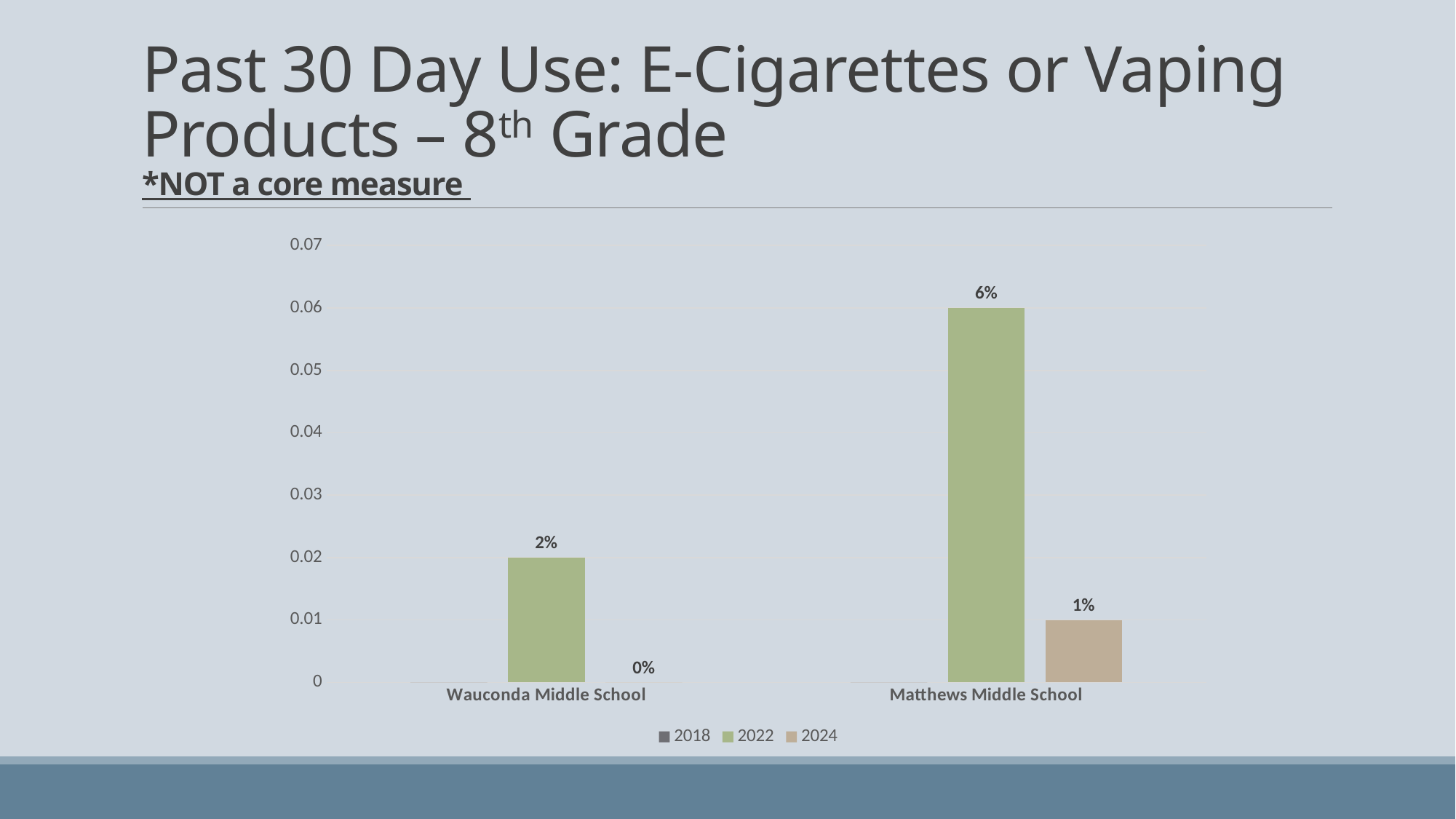
What is the difference between the 2022 and 2024 values for Matthews Middle School? 5% What kind of chart is shown on the slide? Bar chart Which school has the lower 2024 value? Wauconda Middle School What is the 2022 value for Wauconda Middle School? 2% Which school has the higher 2022 value? Matthews Middle School What is the 2022 value for Matthews Middle School? 6% How many schools are shown on the x axis? 2 Which years are listed in the chart legend? 2018, 2022, 2024 What is the difference between the 2022 values for Matthews Middle School and Wauconda Middle School? 4% How many series does the legend list? 3 What is the 2024 value for Matthews Middle School? 1% What is the 2024 value for Wauconda Middle School? 0%